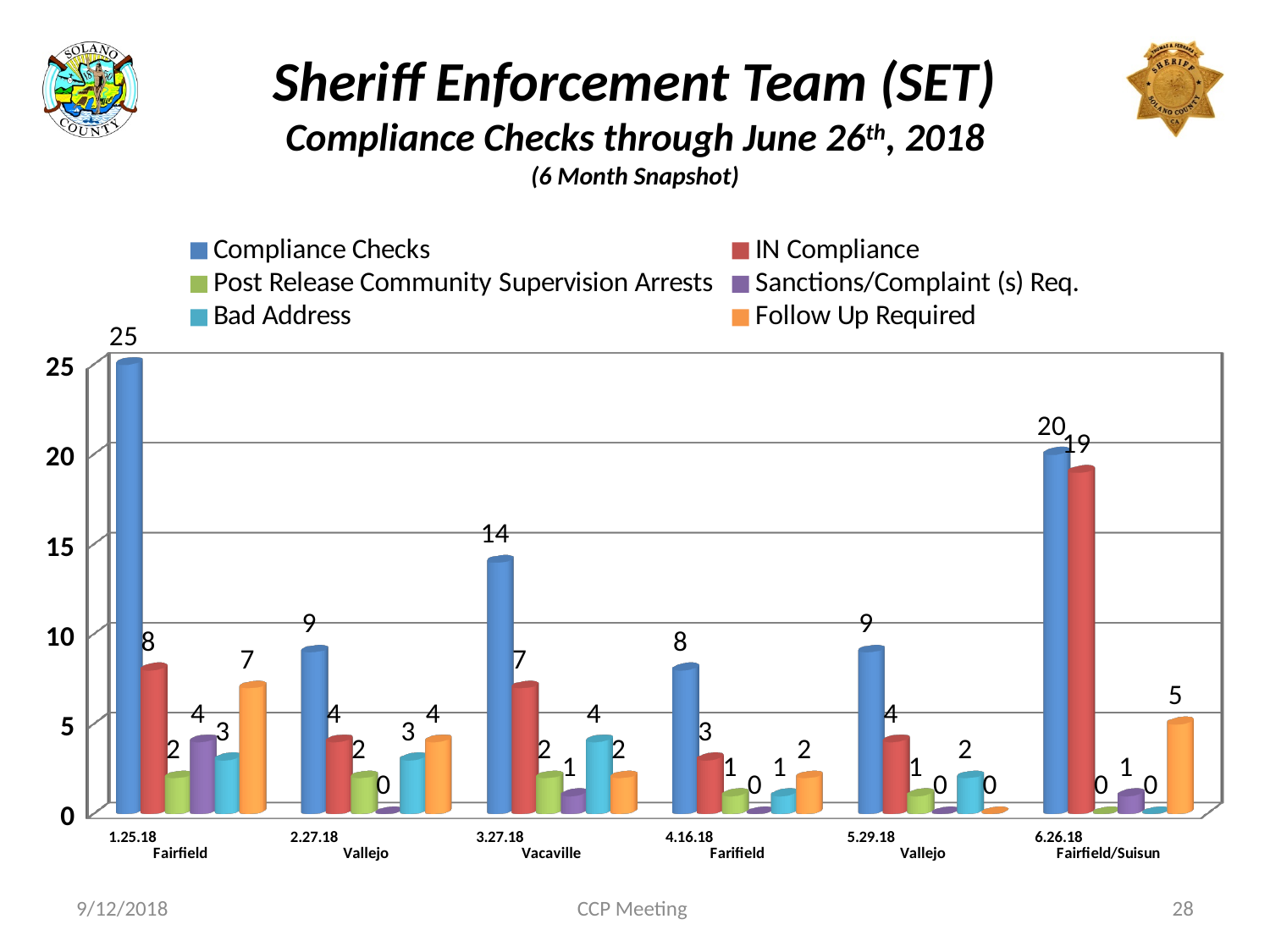
Which date has the highest number of Compliance Checks? 1.25.18 Fairfield Which series is shown in orange in the legend? Follow Up Required What is the Bad Address value for 3.27.18 Vacaville? 4 How many Compliance Checks were conducted on 1.25.18 in Fairfield? 25 What is the Follow Up Required value for 1.25.18 Fairfield? 7 Which date has the lowest number of Compliance Checks? 4.16.18 Farifield How many series does the legend list? 6 What is the IN Compliance value for 6.26.18 Fairfield/Suisun? 19 Which is larger, the Follow Up Required value for 2.27.18 Vallejo or for 6.26.18 Fairfield/Suisun? 6.26.18 Fairfield/Suisun What kind of chart is shown on the slide? Bar chart What is the difference between Compliance Checks and IN Compliance for 3.27.18 Vacaville? 7 How many dates (categories) are shown on the x axis? 6